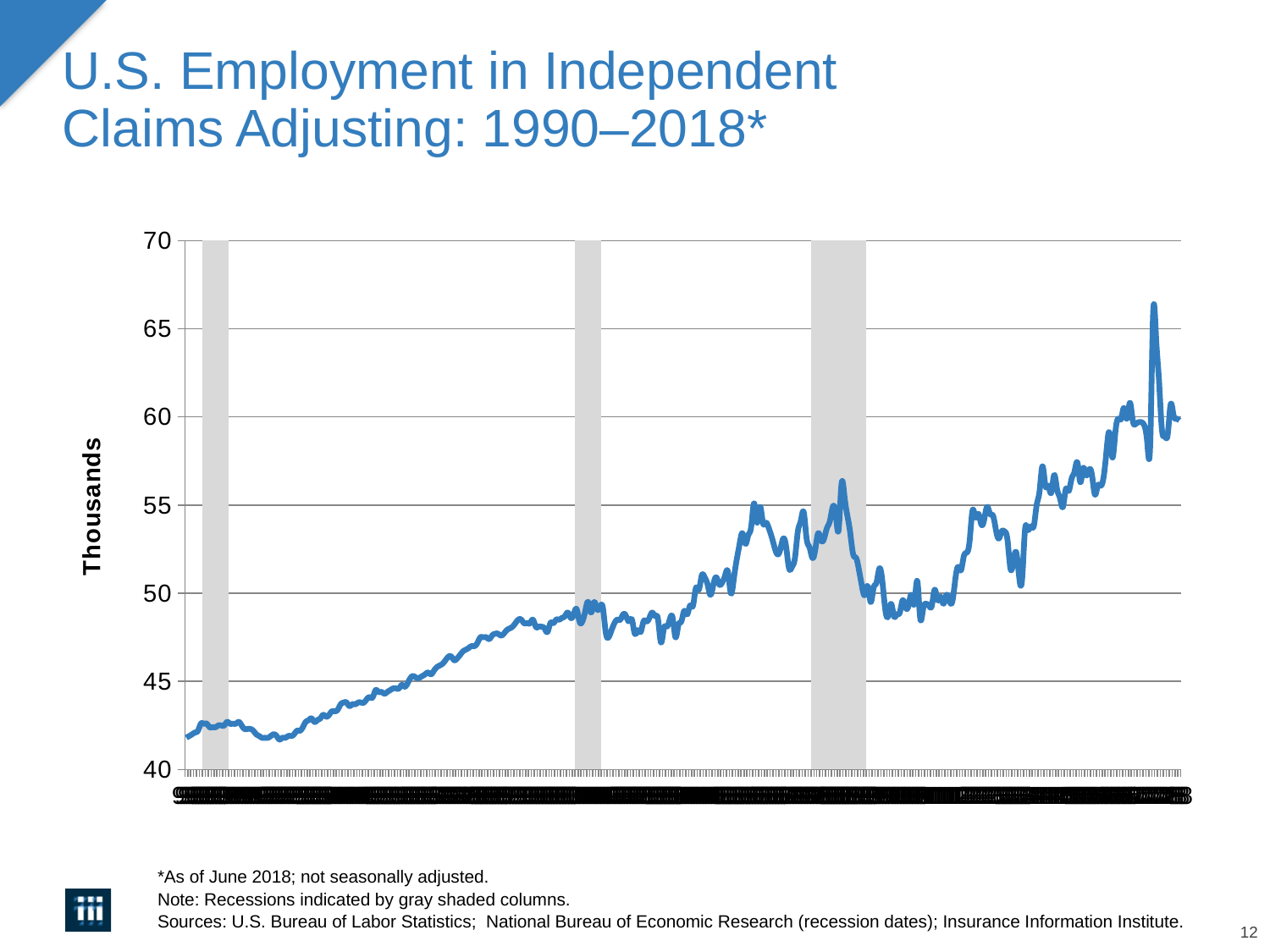
What is the label on the vertical axis of the chart? Thousands Is the value at the start of the line (left end) greater or less than 45? less Is the lowest point on the line greater or less than 45? less Overall, do the values rise or fall from the left of the chart to the right? rise How many gray shaded recession columns are shown on the chart? 3 Is the value at the end of the line (right end) greater or less than 65? less What kind of chart is shown on the slide? line chart